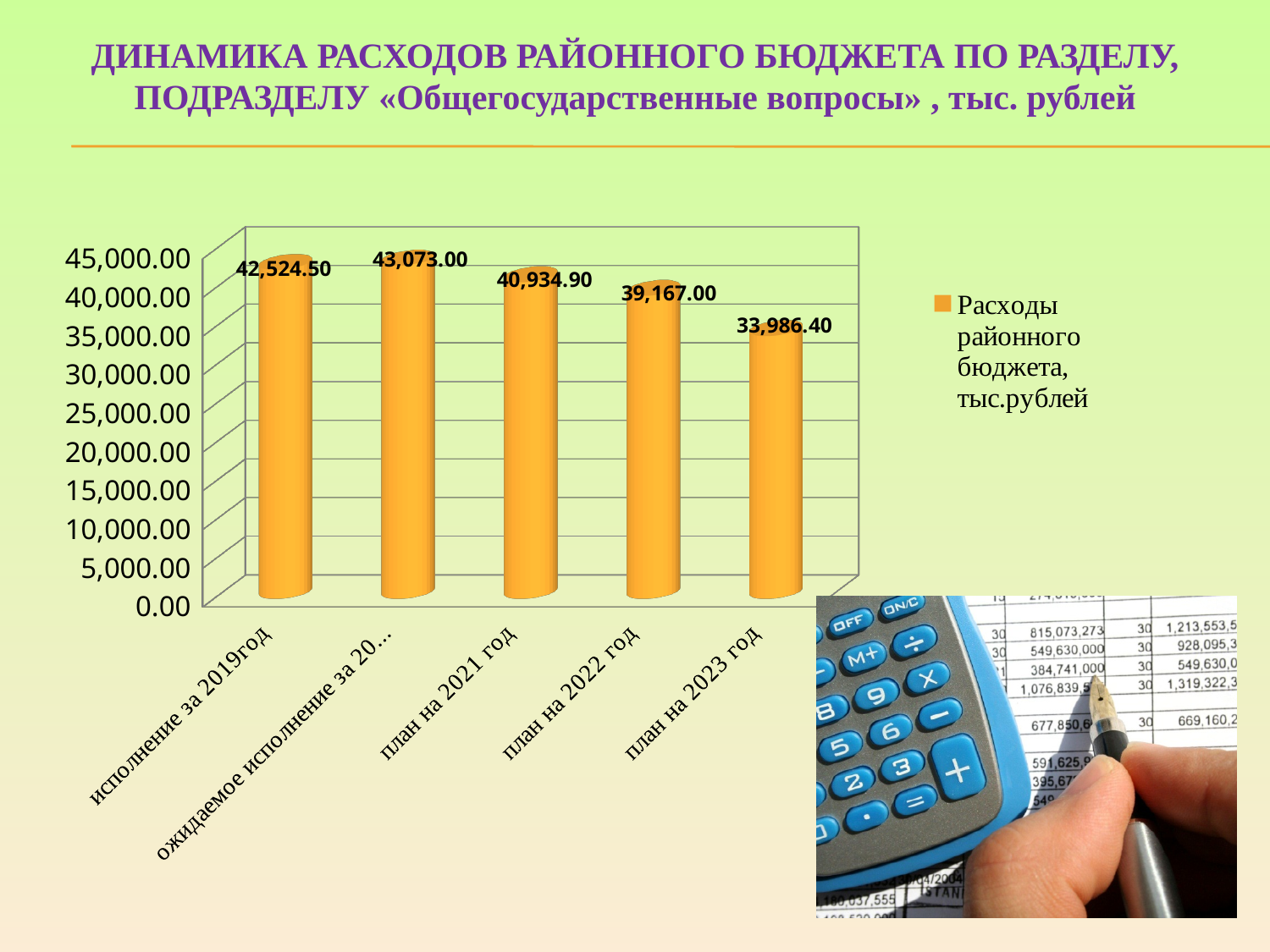
What is the highest value shown on the chart? 43,073.00 Which category has the lowest value? план на 2023 год What is the value for «план на 2022 год»? 39,167.00 How many bars are shown on the chart? 5 What is the value for «план на 2023 год»? 33,986.40 What is the value for «план на 2021 год»? 40,934.90 Is the value for «план на 2023 год» greater or less than 35,000.00? less What is the value for «исполнение за 2019год»? 42,524.50 What is the difference between the values for «план на 2022 год» and «план на 2023 год»? 5,180.60 What kind of chart is shown on the slide? bar chart Which is larger: the value for «план на 2021 год» or the value for «план на 2022 год»? план на 2021 год What series name does the legend show? Расходы районного бюджета, тыс.рублей